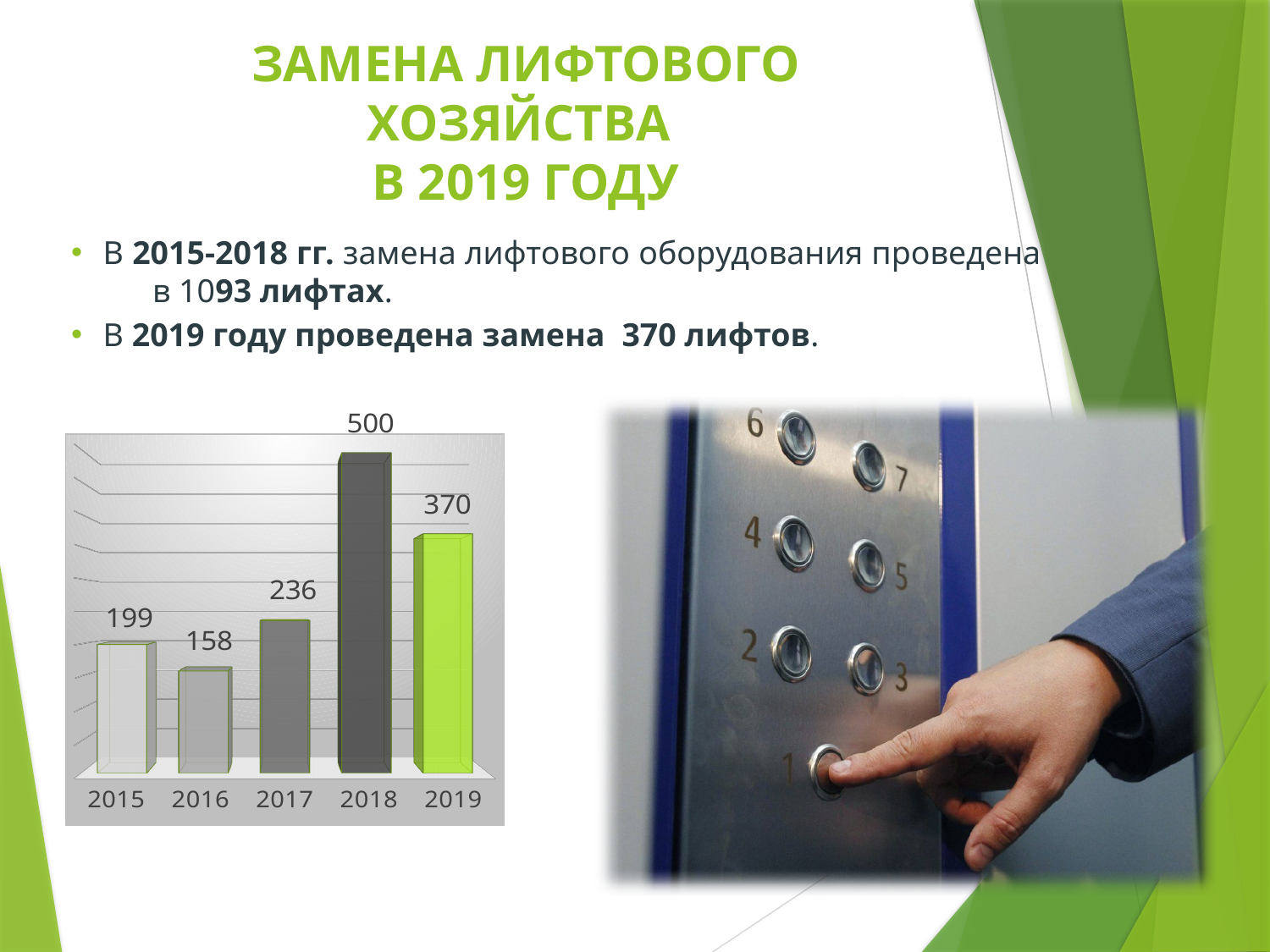
Which bar is coloured green? 2019 What is the difference between the values for 2018 and 2019? 130 What kind of chart is shown on the slide? bar chart What value is shown for 2018? 500 Does the value rise or fall from 2016 to 2018? rise What value is shown for 2019? 370 How many years are shown on the chart? 5 What is the difference between the values for 2017 and 2016? 78 Which year has the highest value? 2018 Which is larger, the value for 2015 or the value for 2017? 2017 What value is shown for 2016? 158 Which year has the lowest value? 2016